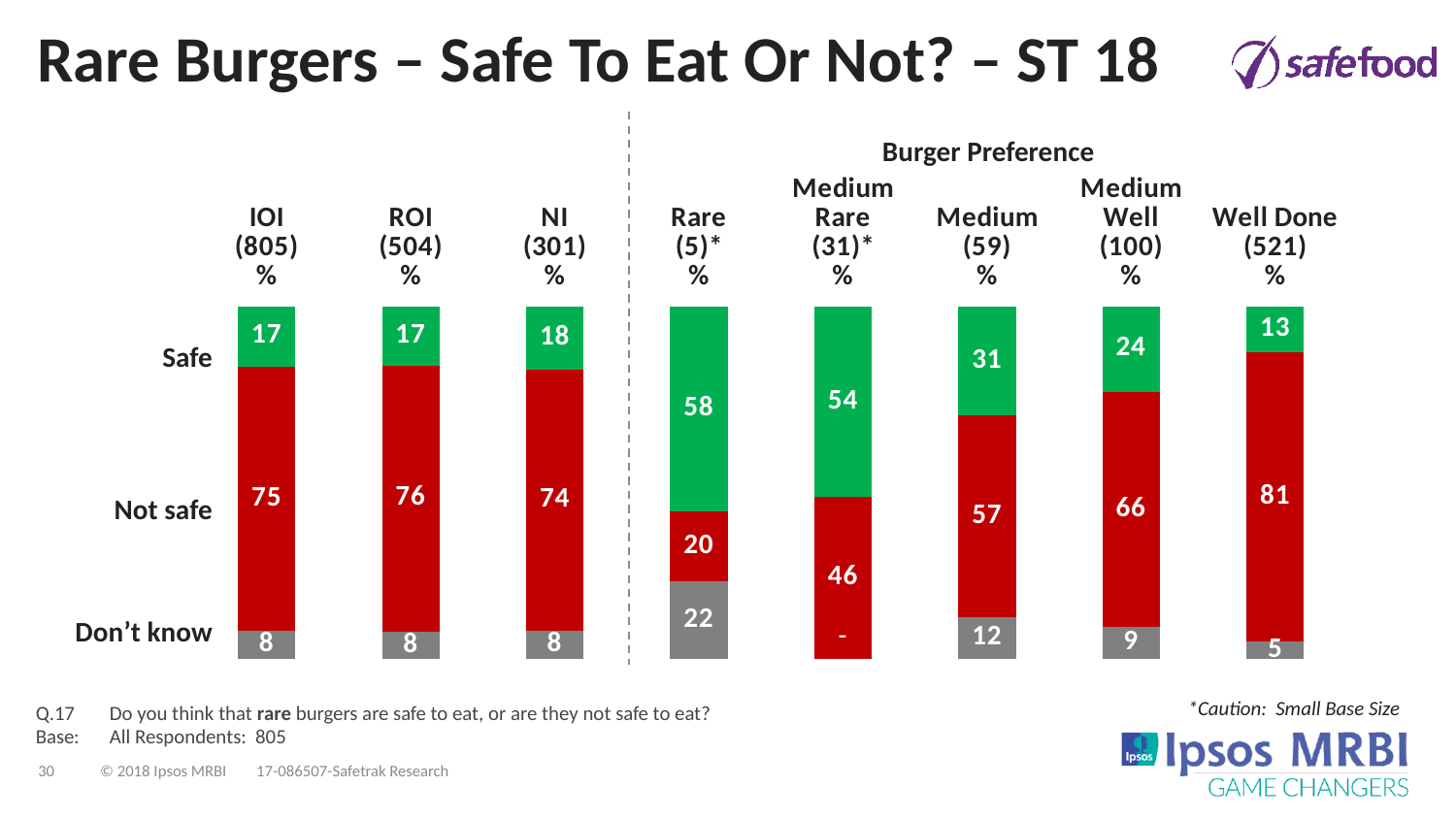
What type of chart is shown on the slide? Stacked bar chart How many response categories are stacked in each bar? 3 Which burger preference group has the highest 'Not safe' value? Well Done What is the 'Don't know' value for the Rare (5)* group? 22 Which group has the lowest 'Safe' value? Well Done Which colour represents the 'Not safe' response in the chart? Red What is the difference between the 'Not safe' values for Well Done and Medium? 24 Which is larger, the 'Safe' value for Rare or for Medium Rare? Rare What percentage of IOI respondents say rare burgers are not safe? 75 What is the 'Safe' value for the Medium Well (100) group? 24 How many groups (bars) are shown in the chart? 8 What is the total of the Medium (59) bar (Safe + Not safe + Don't know)? 100